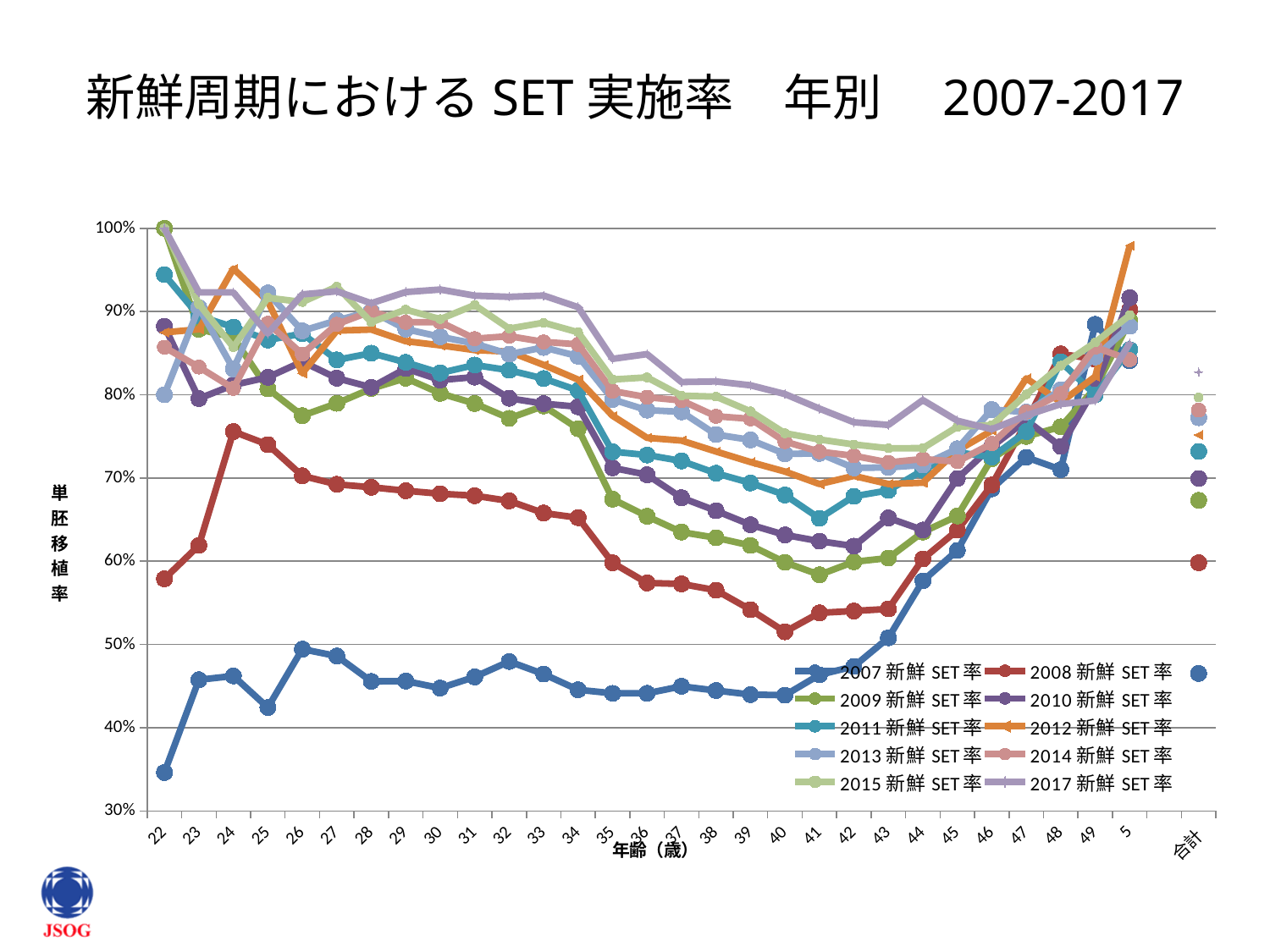
Which series has the lowest value at age 22? 2007 新鮮 SET 率 Which series has the lowest value at age 40? 2007 新鮮 SET 率 At age 30, which is larger: the value for 2008 新鮮 SET 率 or 2007 新鮮 SET 率? 2008 新鮮 SET 率 Is the value for 2008 新鮮 SET 率 at age 40 greater or less than 60%? less What is the title of the chart on the slide? 新鮮周期における SET 実施率 年別 2007-2017 Is the value for 2017 新鮮 SET 率 at age 30 greater or less than 90%? greater Does the 2007 新鮮 SET 率 line rise or fall from age 44 to age 49? rise Is the value for 2007 新鮮 SET 率 in the 合計 column greater or less than 50%? less At age 50, which is larger: the value for 2012 新鮮 SET 率 or 2008 新鮮 SET 率? 2012 新鮮 SET 率 What kind of chart is shown on the slide? line chart How many series does the legend list? 10